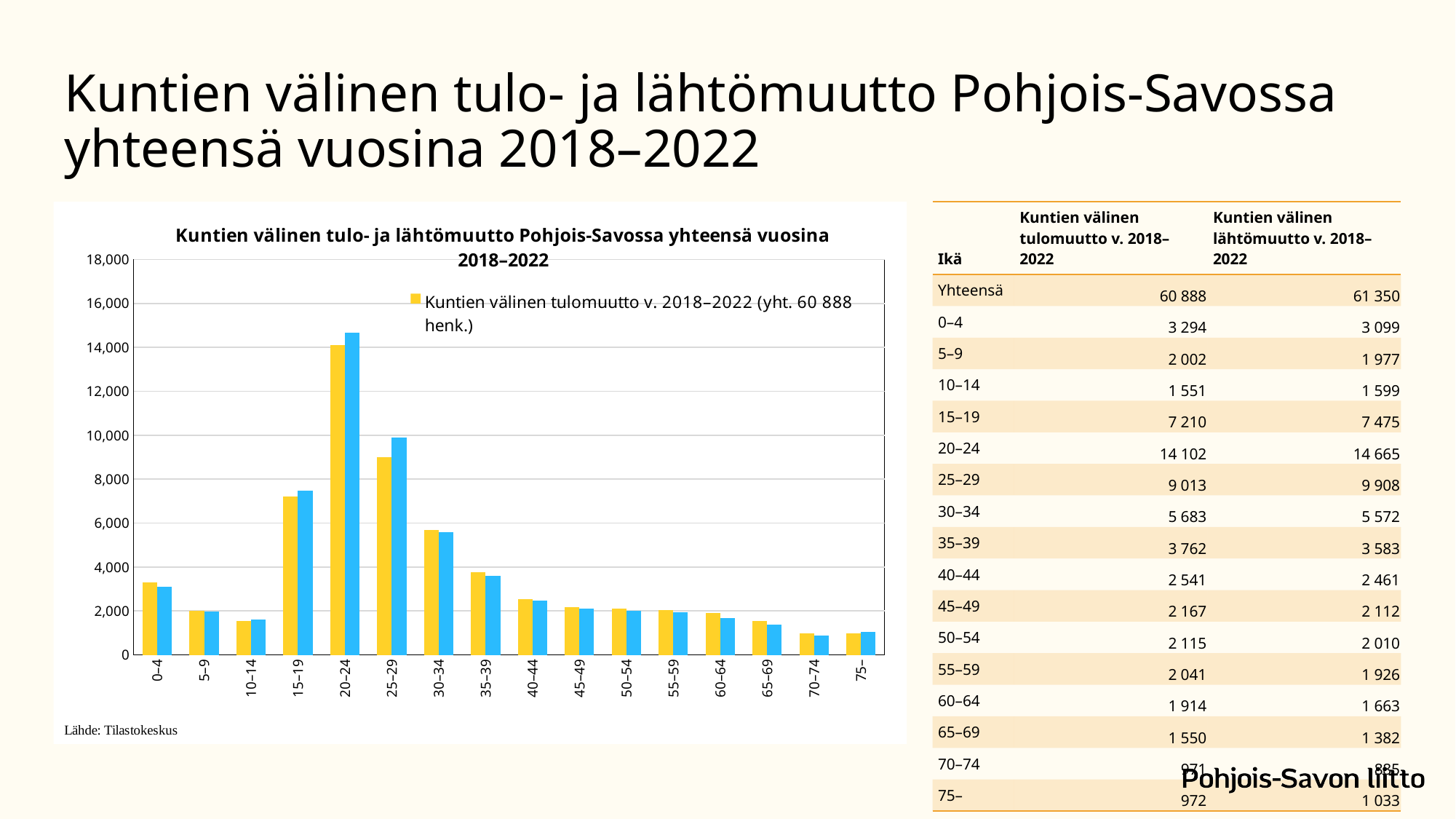
What is the value of Kuntien välinen lähtömuutto v. 2018–2022 for the 25–29 age group? 9 908 For the 20–24 age group, which is larger: tulomuutto or lähtömuutto? lähtömuutto What is the difference between lähtömuutto and tulomuutto for the 20–24 age group? 563 What is the value of Kuntien välinen tulomuutto v. 2018–2022 for the 20–24 age group? 14 102 Is the tulomuutto value for the 15–19 age group greater or less than 6,000? greater Do the tulomuutto values rise or fall along the x axis from the 20–24 age group to the 70–74 age group? fall What kind of chart is shown on the slide? bar chart How many age groups are shown on the x axis of the chart? 16 What is the total (Yhteensä) value of Kuntien välinen tulomuutto v. 2018–2022? 60 888 Is the tulomuutto value for the 0–4 age group greater or less than 4,000? less Which age group has the highest value for Kuntien välinen tulomuutto v. 2018–2022? 20–24 What colour are the bars for Kuntien välinen tulomuutto v. 2018–2022? yellow